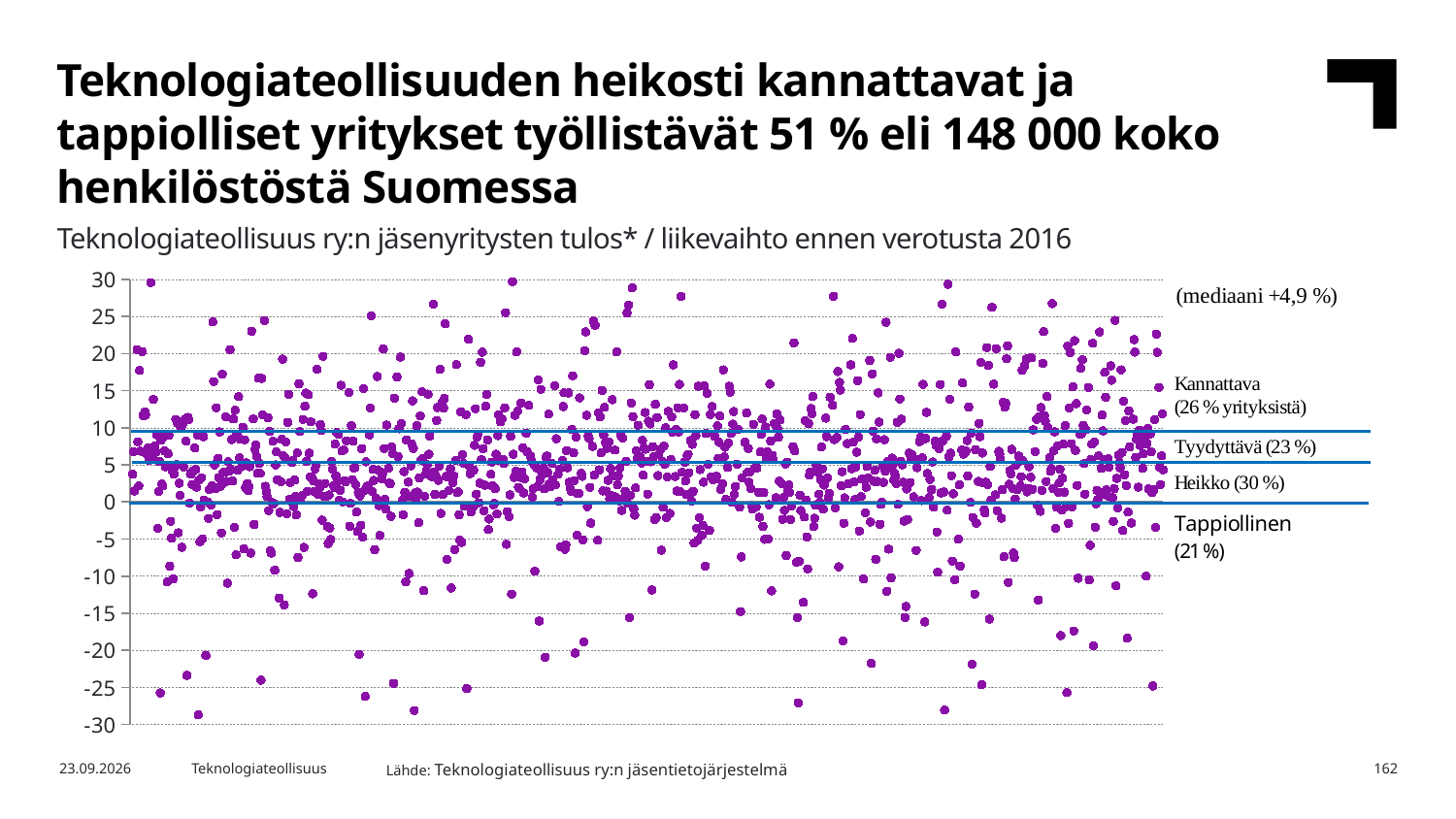
How many percentage points larger is the Heikko share than the Tappiollinen share? 9 What share of companies falls into the Tappiollinen category? 21 % What share of companies falls into the Tyydyttävä category? 23 % What is the highest value shown on the vertical axis? 30 What kind of chart is shown on the slide? Scatter chart What share of companies falls into the Heikko category? 30 % How many profitability categories are labelled on the chart? 4 Which profitability category contains the largest share of companies? Heikko What share of companies falls into the Kannattava category? 26 % Which category has a larger share of companies, Kannattava or Tyydyttävä? Kannattava What is the median value (mediaani) noted on the chart? +4,9 % Which profitability category contains the smallest share of companies? Tappiollinen